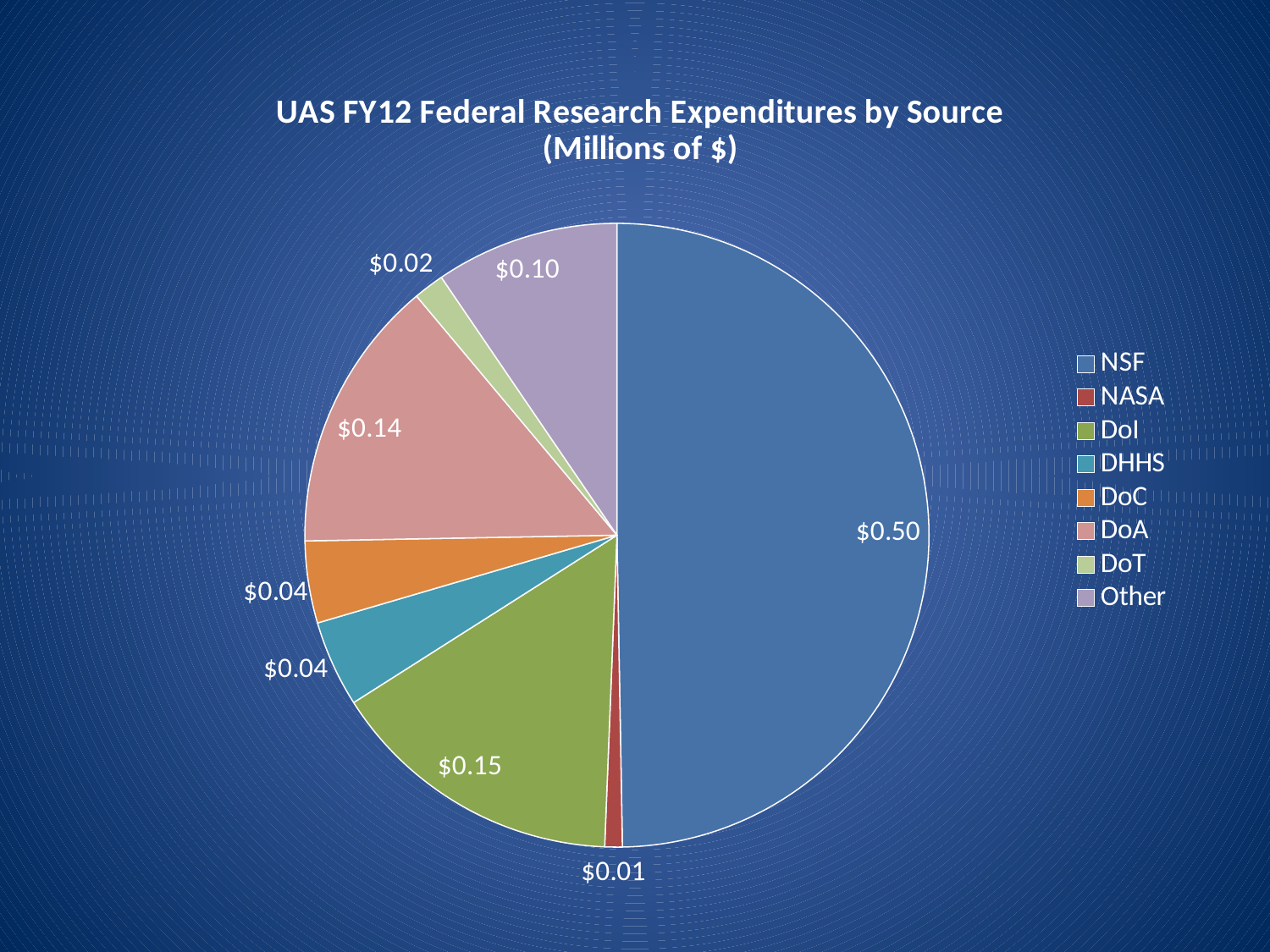
What is the title of the chart? UAS FY12 Federal Research Expenditures by Source (Millions of $) What type of chart is shown on the slide? pie chart What is the value for DoA? $0.14 What is the value for Other? $0.10 What is the value for NSF? $0.50 What is the value for DoI? $0.15 How many sources are listed in the legend? 8 Which is larger, the value for DoA or the value for Other? DoA Which source has the smallest slice? NASA Which source has the largest slice? NSF What is the difference between the NSF value and the DoI value? $0.35 What share of the pie does the NSF slice represent? 50%